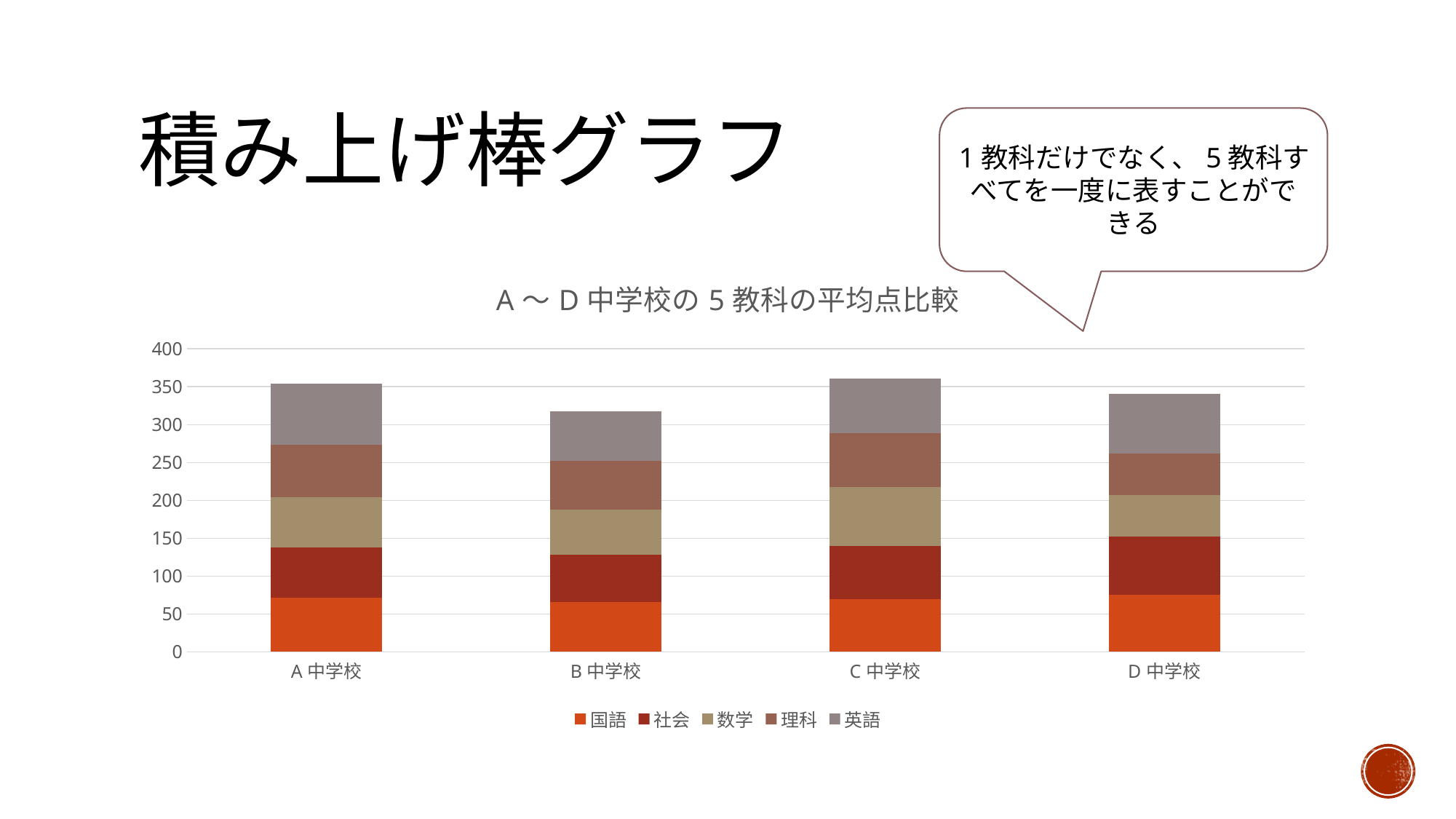
Is the total stacked value for D中学校 greater or less than 350? less Which has the larger total stacked bar, A中学校 or B中学校? A中学校 Which school has the lowest total stacked bar? B中学校 How many series does the chart's legend list? 5 What is the title of the chart? A～D中学校の5教科の平均点比較 Is the total stacked value for B中学校 greater or less than 350? less What kind of chart is shown on the slide? Stacked bar chart Is the total stacked value for C中学校 greater or less than 350? greater Which has the larger total stacked bar, B中学校 or D中学校? D中学校 Which series are listed in the chart's legend? 国語, 社会, 数学, 理科, 英語 How many schools (categories) are shown on the x axis of the chart? 4